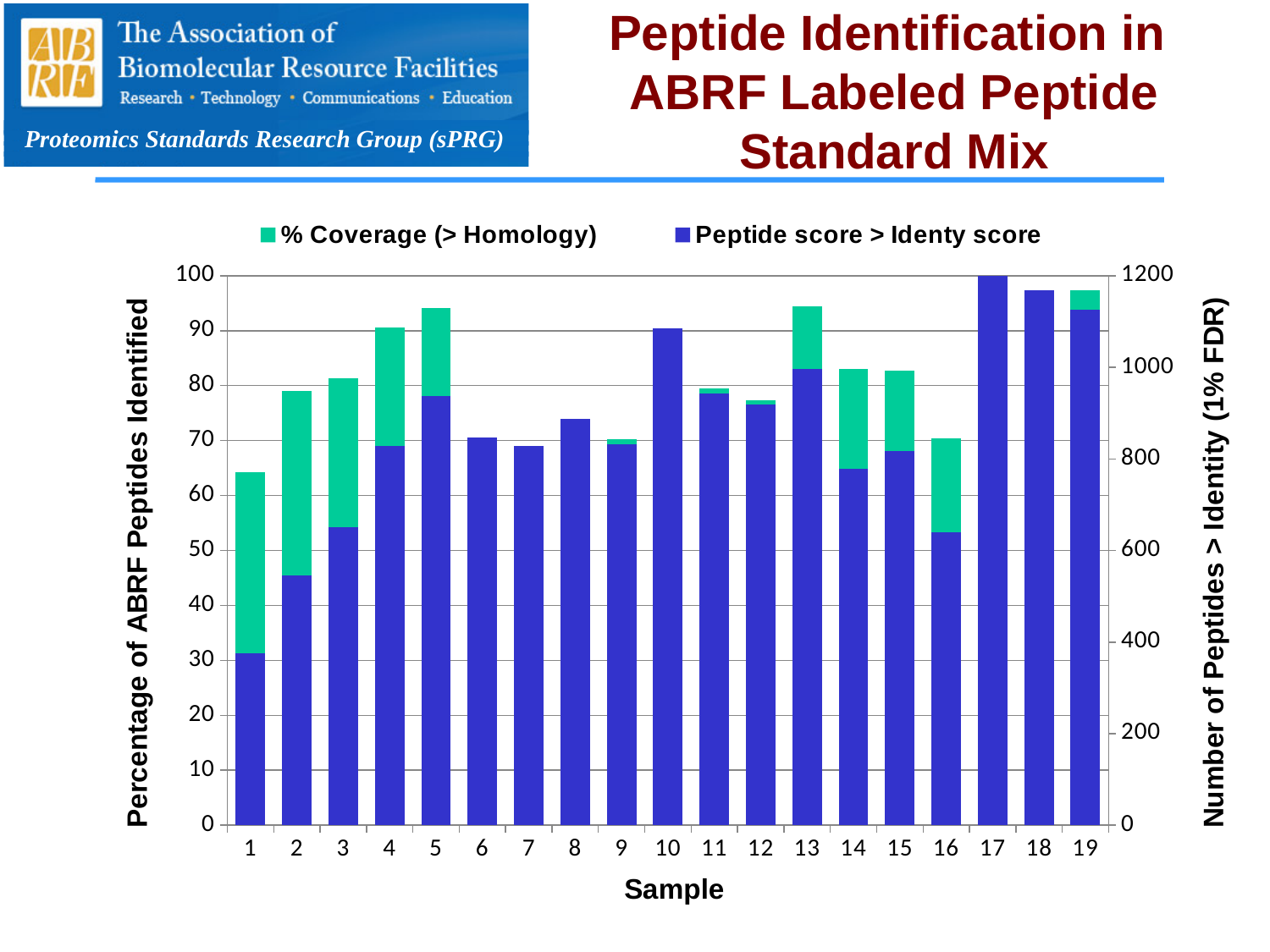
How many series does the legend list? 2 Which sample has the shortest total bar? 1 What is the title of the x axis? Sample How many samples are plotted along the x axis? 19 Which has the larger 'Peptide score > Identy score' segment, sample 4 or sample 5? 5 Which sample has the tallest total bar? 17 Is the 'Peptide score > Identy score' value for sample 1 greater or less than 40 on the left axis? less Is the 'Peptide score > Identy score' value for sample 16 greater or less than 60 on the left axis? less Which sample has the smallest 'Peptide score > Identy score' segment? 1 Which has the taller total bar, sample 8 or sample 10? 10 Is the total bar height for sample 10 greater or less than 80 on the left axis? greater What kind of chart is shown on the slide? Bar chart